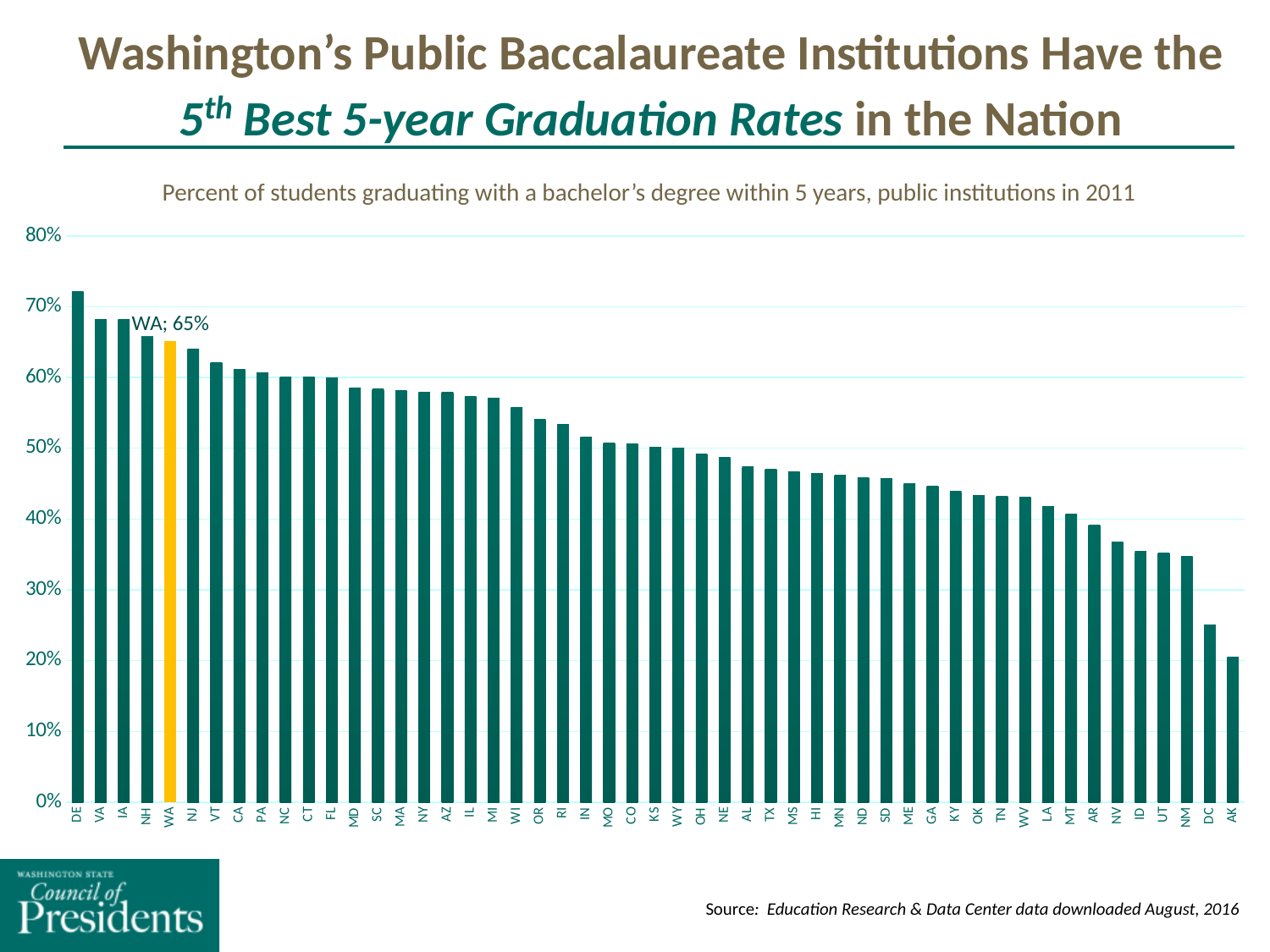
What kind of chart is shown on the slide? Bar chart Is the value for AK greater or less than 30%? less Which has a lower 5-year graduation rate, DC or NM? DC Which state has the lowest 5-year graduation rate in the chart? AK Do the values rise or fall moving from left to right along the x axis? Fall Is the value for NV greater or less than 40%? less How many states/jurisdictions are plotted in the chart? 51 Which state has the highest 5-year graduation rate in the chart? DE Which has a higher 5-year graduation rate, VA or NJ? VA Is the value for DE greater or less than 70%? greater Which bar is highlighted in a different colour (yellow) from the rest? WA What is the 5-year graduation rate shown for WA? 65%